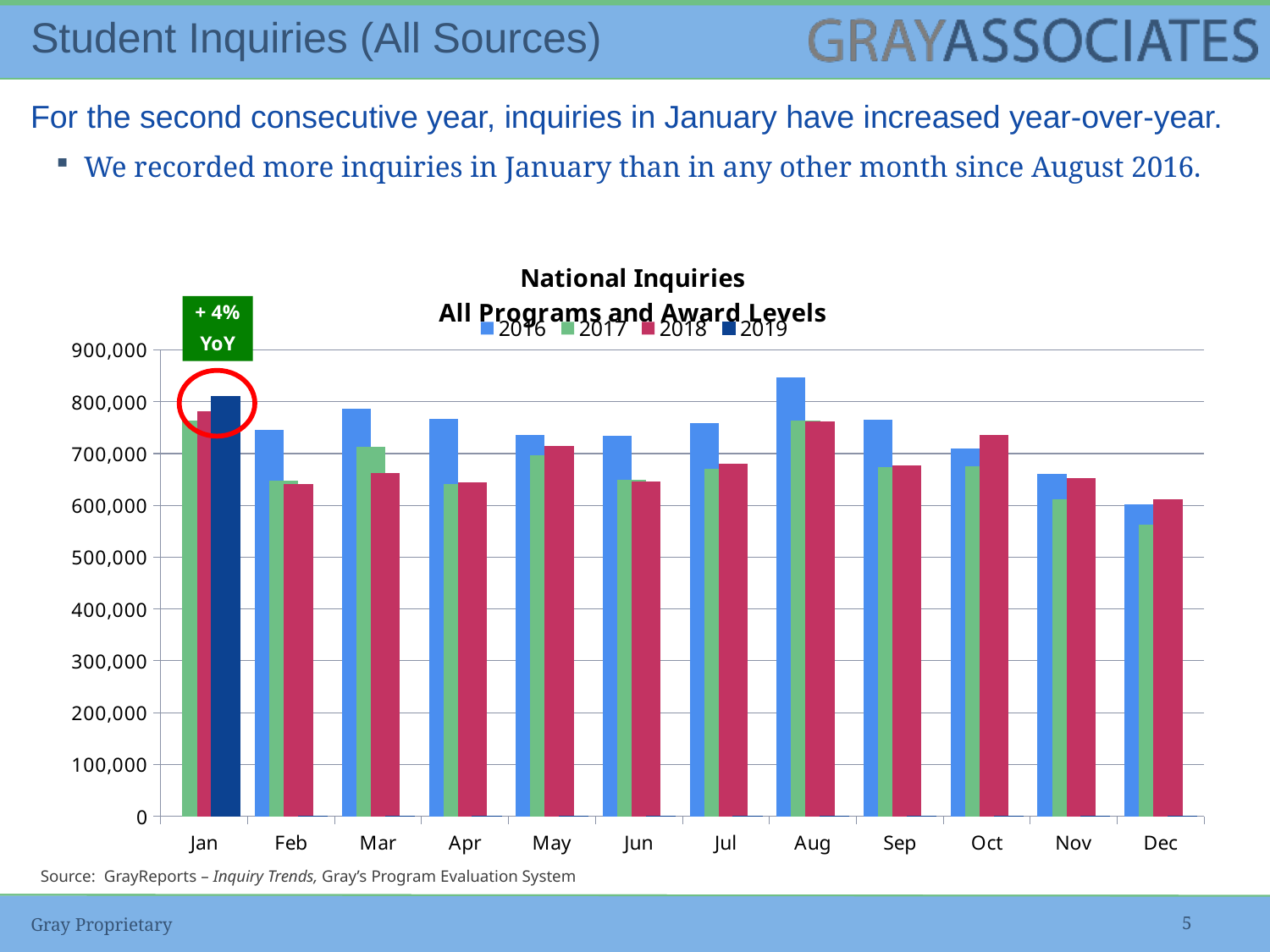
Which month has the highest 2016 value in the National Inquiries chart? Aug How many series does the legend of the National Inquiries chart list? 4 Is the 2019 value for Jan greater or less than 700,000? greater What year-over-year change is shown in the green annotation above the Jan bars? + 4% YoY In Mar, which series has the larger value, 2016 or 2017? 2016 Is the 2017 value for Dec greater or less than 600,000? less In Oct, which series has the larger value, 2016 or 2018? 2018 Which month has the lowest 2018 value in the National Inquiries chart? Dec Is the 2016 value for Aug greater or less than 800,000? greater Which month has the lowest 2017 value in the National Inquiries chart? Dec How many months are shown on the x axis of the National Inquiries chart? 12 What kind of chart is shown on the slide? bar chart